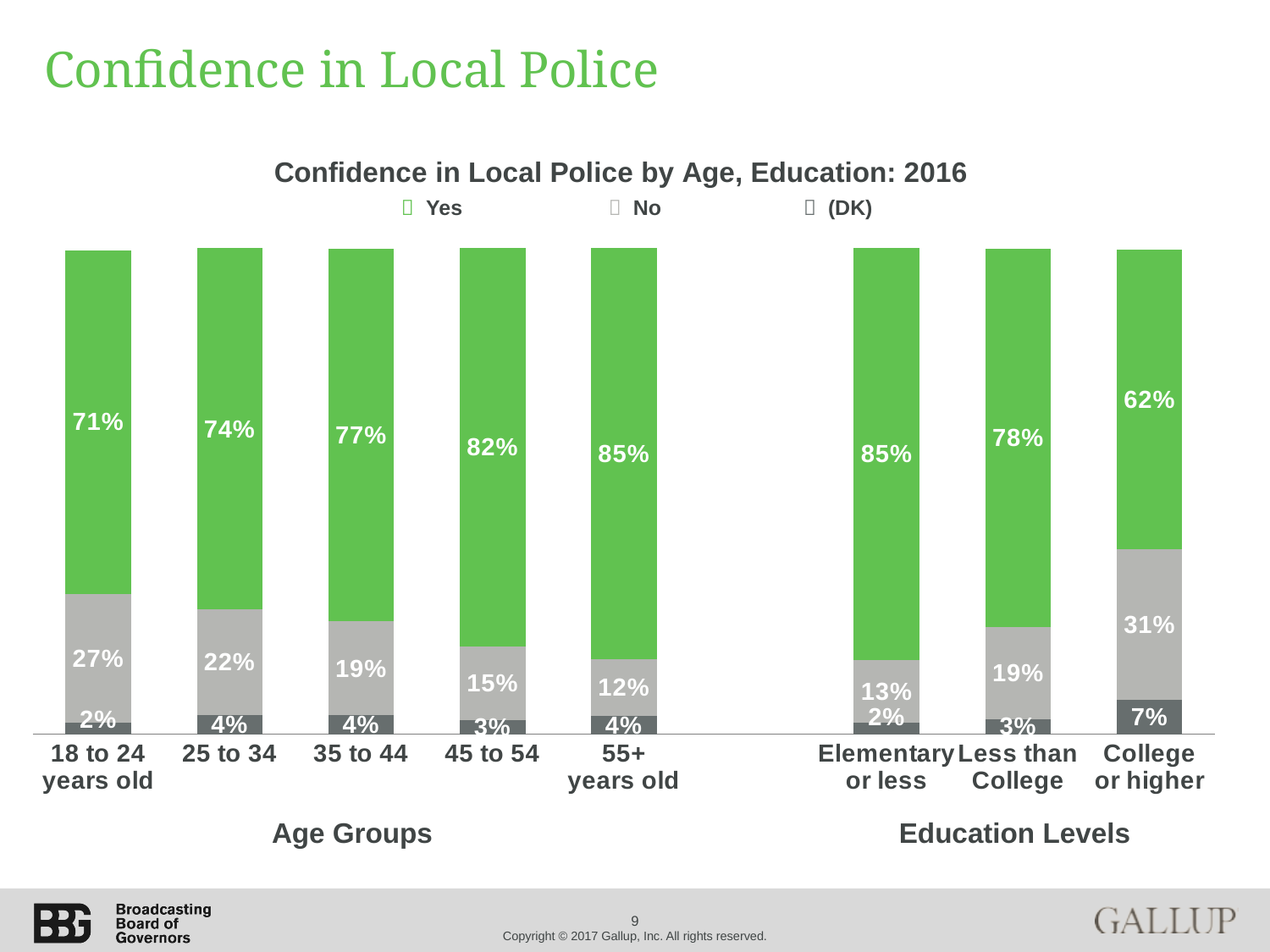
What kind of chart is shown on the slide? Stacked bar chart What is the No value for the College or higher education group? 31% Which age group has the highest Yes percentage? 55+ years old What is the (DK) value for the 45 to 54 age group? 3% What percentage of 18 to 24 year olds answered Yes to having confidence in local police? 71% How many categories are shown on the x axis in total? 8 What is the title of the chart? Confidence in Local Police by Age, Education: 2016 Which education level has the lowest Yes percentage? College or higher Which is larger, the No value for 25 to 34 or the No value for Less than College? 25 to 34 How many series does the legend list? 3 What is the difference between the Yes values for the 55+ years old group and the 18 to 24 years old group? 14% Do the Yes values rise or fall across the age groups from 18 to 24 to 55+? Rise